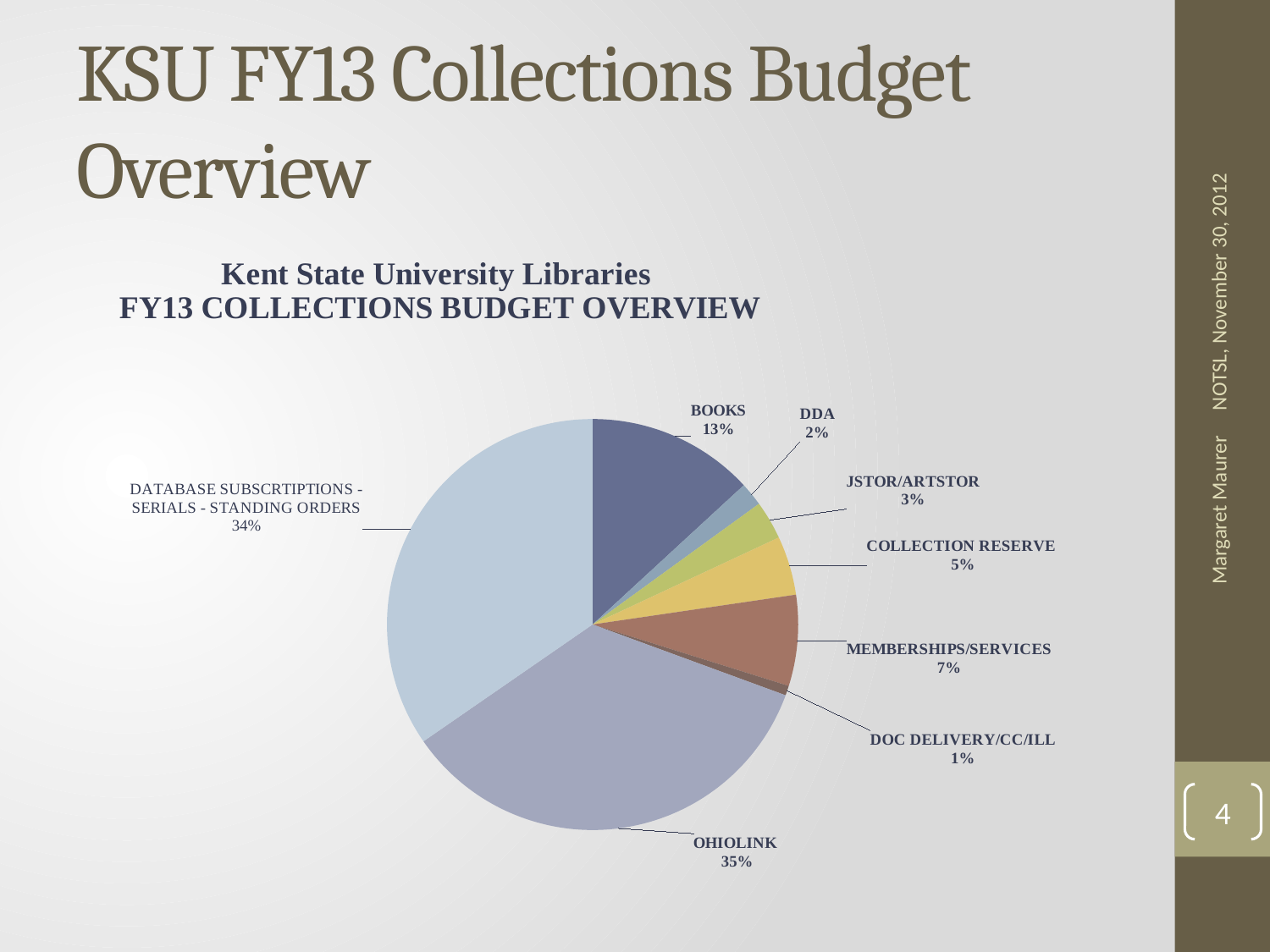
Which category has the smallest share of the budget? DOC DELIVERY/CC/ILL What share of the FY13 collections budget goes to OHIOLINK? 35% What is the title printed above the pie chart? Kent State University Libraries FY13 COLLECTIONS BUDGET OVERVIEW What kind of chart is shown on the slide? Pie chart What is the difference in percentage points between BOOKS and MEMBERSHIPS/SERVICES? 6 What share of the budget is for BOOKS? 13% What percentage of the budget is allocated to MEMBERSHIPS/SERVICES? 7% Which is larger, the share for JSTOR/ARTSTOR or the share for DDA? JSTOR/ARTSTOR How many categories are shown in the pie chart? 8 Which category has the largest share of the budget? OHIOLINK